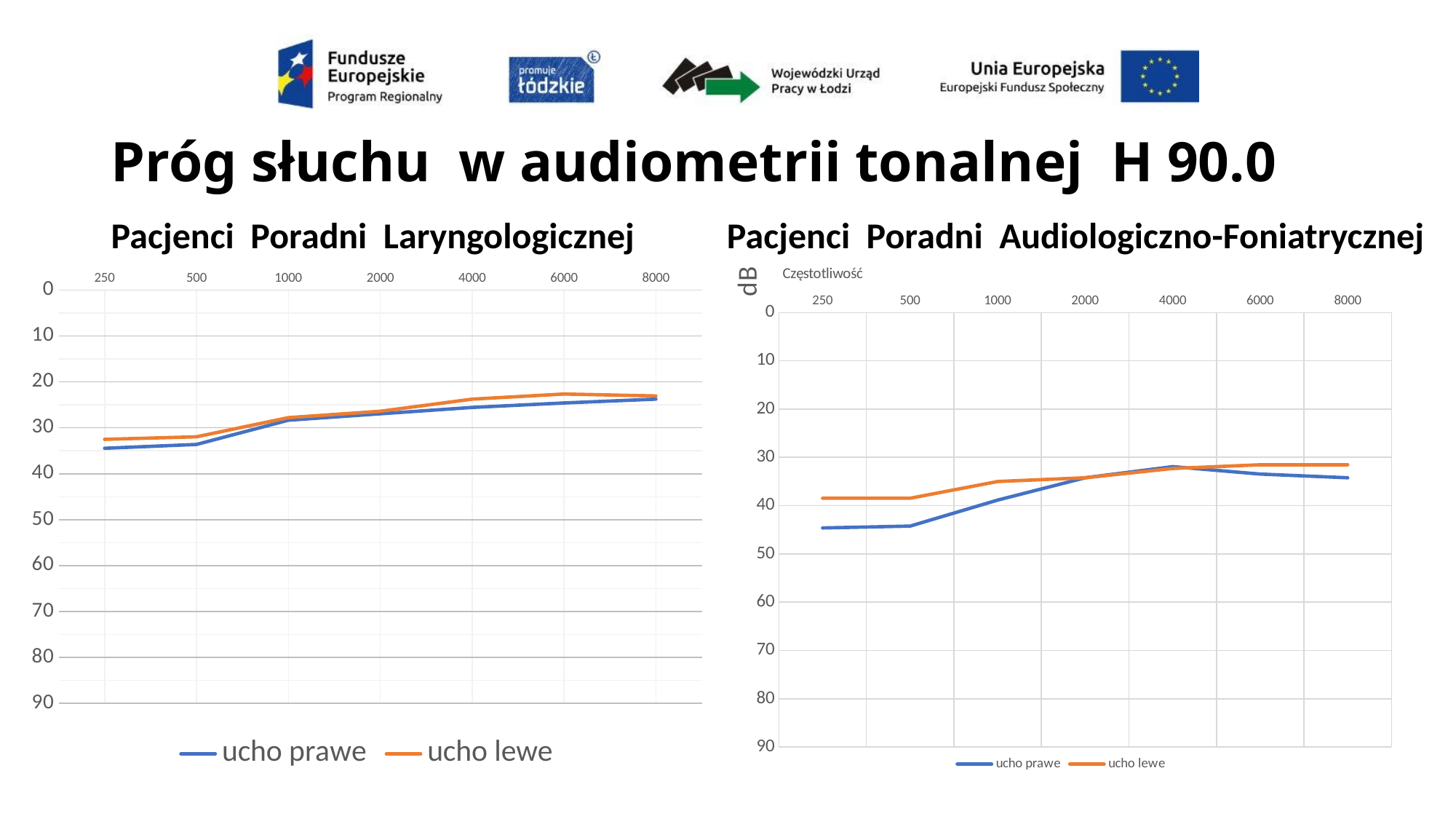
What kind of chart is the 'Pacjenci Poradni Audiologiczno-Foniatrycznej' chart? line chart In the 'Pacjenci Poradni Audiologiczno-Foniatrycznej' chart, is the value for 'ucho prawe' at 250 greater or less than 40? greater How many frequency categories are shown on the x axis of the 'Pacjenci Poradni Audiologiczno-Foniatrycznej' chart? 7 In the 'Pacjenci Poradni Laryngologicznej' chart, do the 'ucho lewe' values rise or fall numerically from 250 to 8000? fall In the 'Pacjenci Poradni Laryngologicznej' chart, is the value for 'ucho prawe' at 8000 greater or less than 30? less How many series does the legend of the 'Pacjenci Poradni Laryngologicznej' chart list? 2 In the 'Pacjenci Poradni Audiologiczno-Foniatrycznej' chart, which series has the larger value at 250, 'ucho prawe' or 'ucho lewe'? ucho prawe What kind of chart is the 'Pacjenci Poradni Laryngologicznej' chart? line chart In the 'Pacjenci Poradni Audiologiczno-Foniatrycznej' chart, is the value for 'ucho lewe' at 1000 greater or less than 40? less How many frequency categories are shown on the x axis of the 'Pacjenci Poradni Laryngologicznej' chart? 7 What are the two legend entries of the 'Pacjenci Poradni Laryngologicznej' chart? ucho prawe, ucho lewe